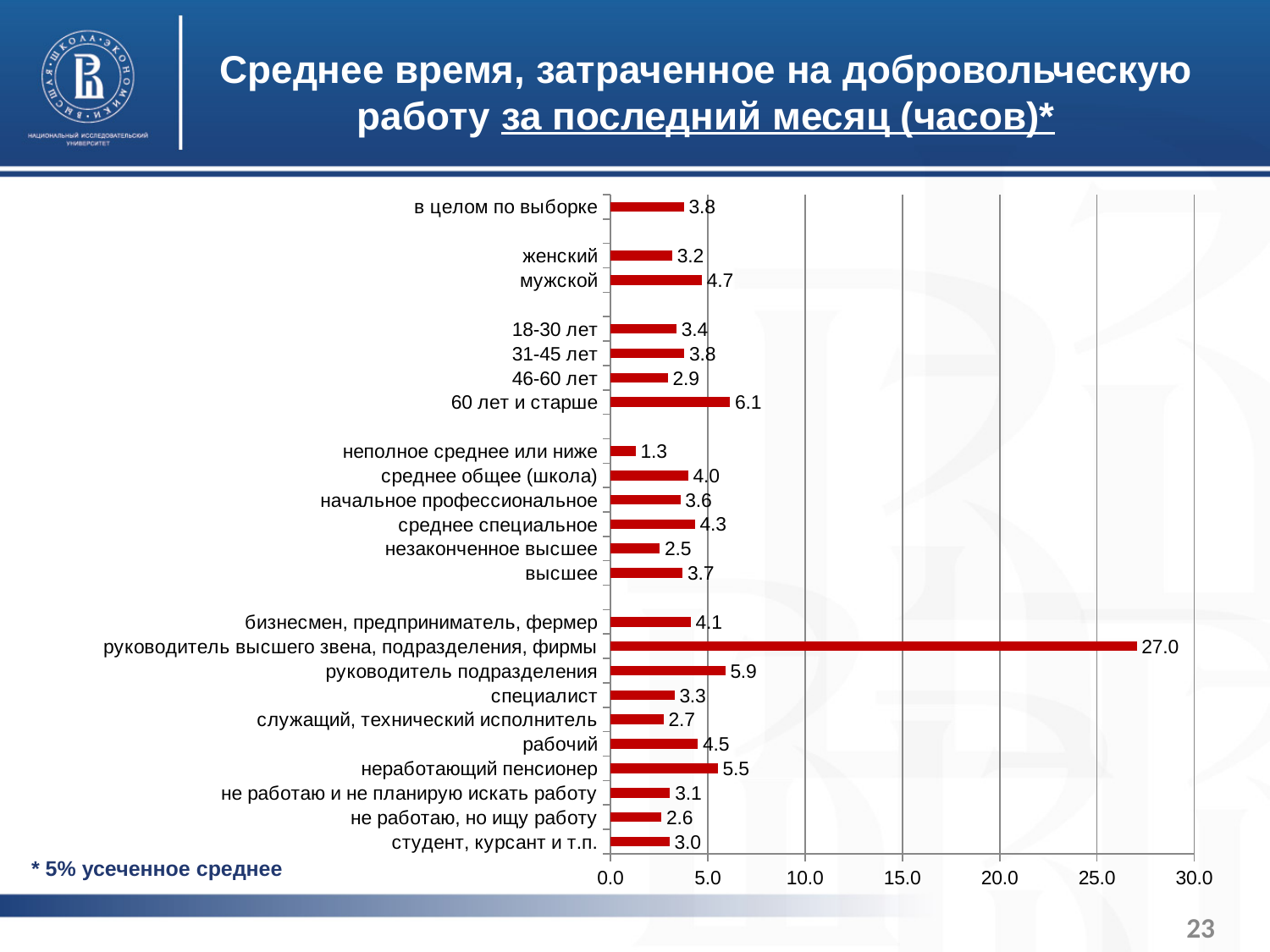
What is the value for «в целом по выборке»? 3.8 What kind of chart is shown on the slide? bar chart Is the value for «руководитель высшего звена, подразделения, фирмы» greater or less than 25.0? greater What is the value for «мужской»? 4.7 Which category has the lowest value? неполное среднее или ниже What is the difference between the values for «мужской» and «женский»? 1.5 How many categories are shown in the chart? 23 What is the value for «неработающий пенсионер»? 5.5 What is the maximum value shown on the x axis? 30.0 What is the value for «60 лет и старше»? 6.1 Which category has the highest value? руководитель высшего звена, подразделения, фирмы Which is larger, the value for «рабочий» or the value for «специалист»? рабочий